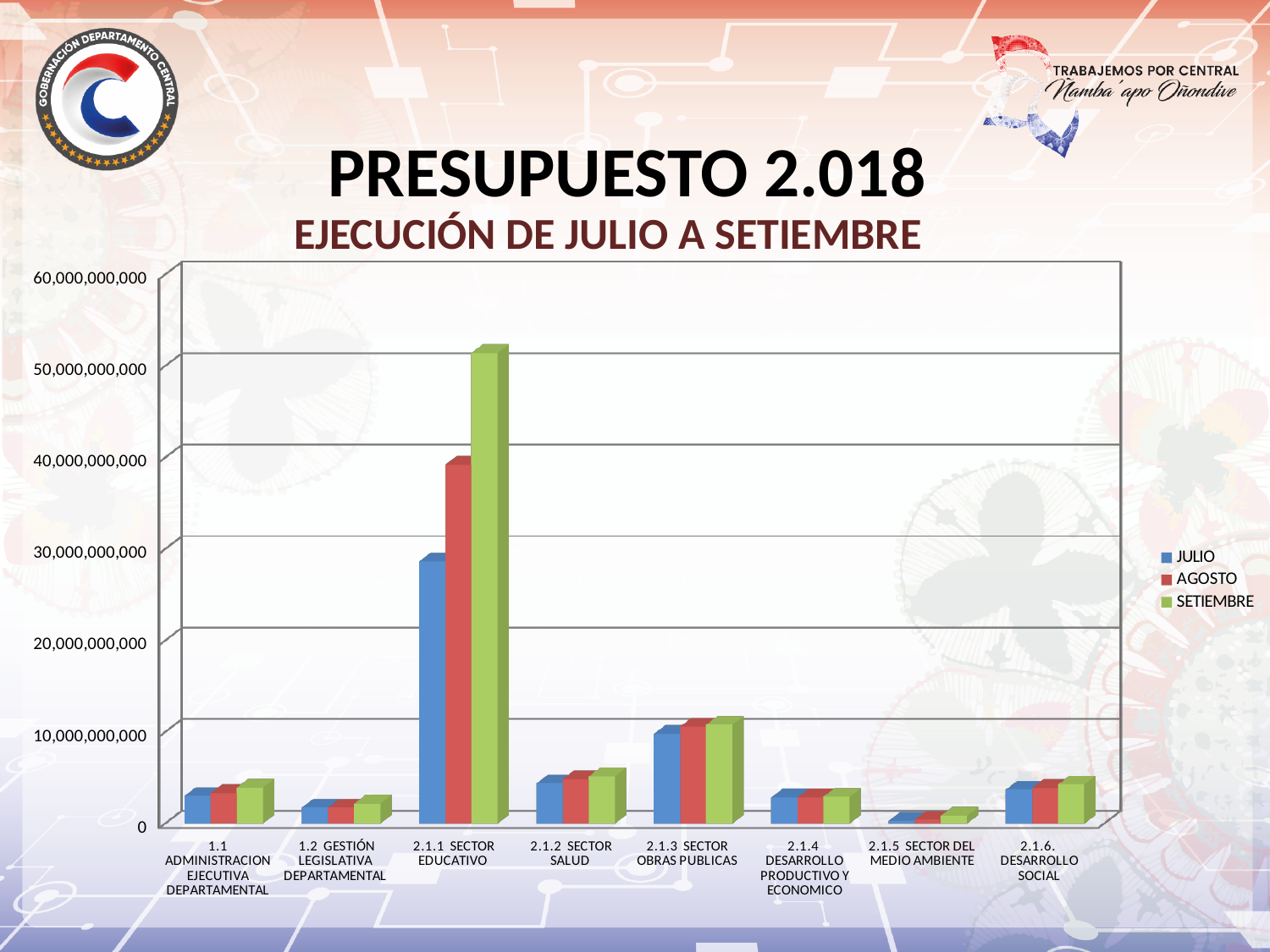
What kind of chart is shown on the slide? Bar chart How many series does the chart's legend list? 3 Which category has the lowest bars in the chart? 2.1.5 SECTOR DEL MEDIO AMBIENTE For the SETIEMBRE series, which is larger: 2.1.3 SECTOR OBRAS PUBLICAS or 2.1.2 SECTOR SALUD? 2.1.3 SECTOR OBRAS PUBLICAS For 2.1.1 SECTOR EDUCATIVO, do the values rise or fall from JULIO to SETIEMBRE? rise For the JULIO series, which is larger: 2.1.1 SECTOR EDUCATIVO or 2.1.3 SECTOR OBRAS PUBLICAS? 2.1.1 SECTOR EDUCATIVO Which category has the highest bars in the chart? 2.1.1 SECTOR EDUCATIVO Is the AGOSTO value for 2.1.2 SECTOR SALUD greater or less than 10,000,000,000? less How many categories are shown along the x axis of the chart? 8 Is the SETIEMBRE value for 2.1.1 SECTOR EDUCATIVO greater or less than 40,000,000,000? greater Is the JULIO value for 2.1.1 SECTOR EDUCATIVO greater or less than 30,000,000,000? less Which colour represents the SETIEMBRE series in the chart's legend? Green